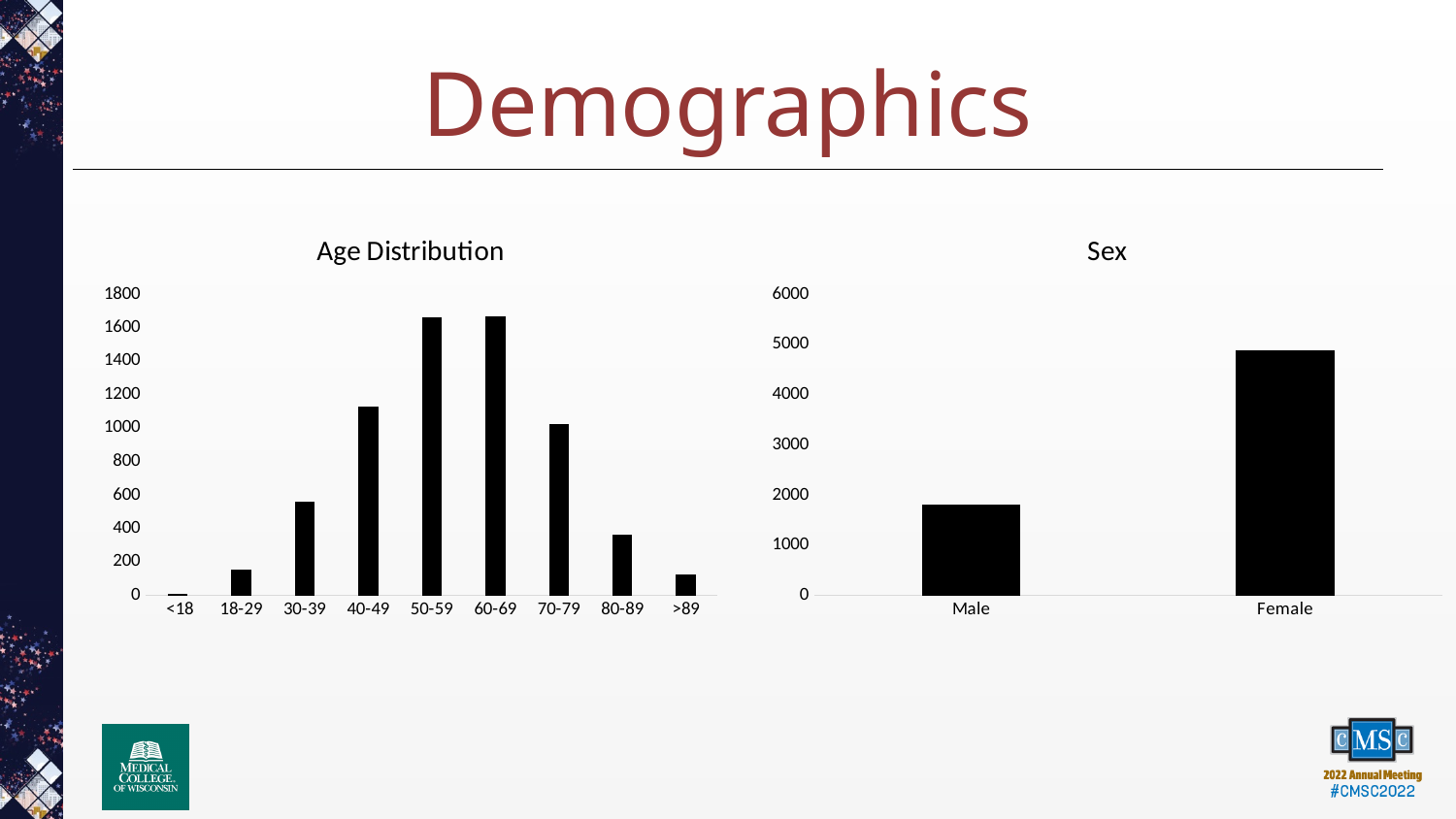
On the Age Distribution chart, is the value for 30-39 greater or less than 600? less On the Age Distribution chart, is the value for 40-49 greater or less than 1000? greater On the Age Distribution chart, which is larger, the value for 18-29 or the value for 30-39? 30-39 On the Age Distribution chart, which age group has the lowest value? <18 What kind of chart is the Sex chart? bar chart On the Age Distribution chart, which is larger, the value for 40-49 or the value for 70-79? 40-49 On the Sex chart, which category has the higher value? Female What kind of chart is the Age Distribution chart? bar chart On the Age Distribution chart, is the value for 80-89 greater or less than 400? less How many age categories are shown on the Age Distribution chart? 9 How many categories are shown on the Sex chart? 2